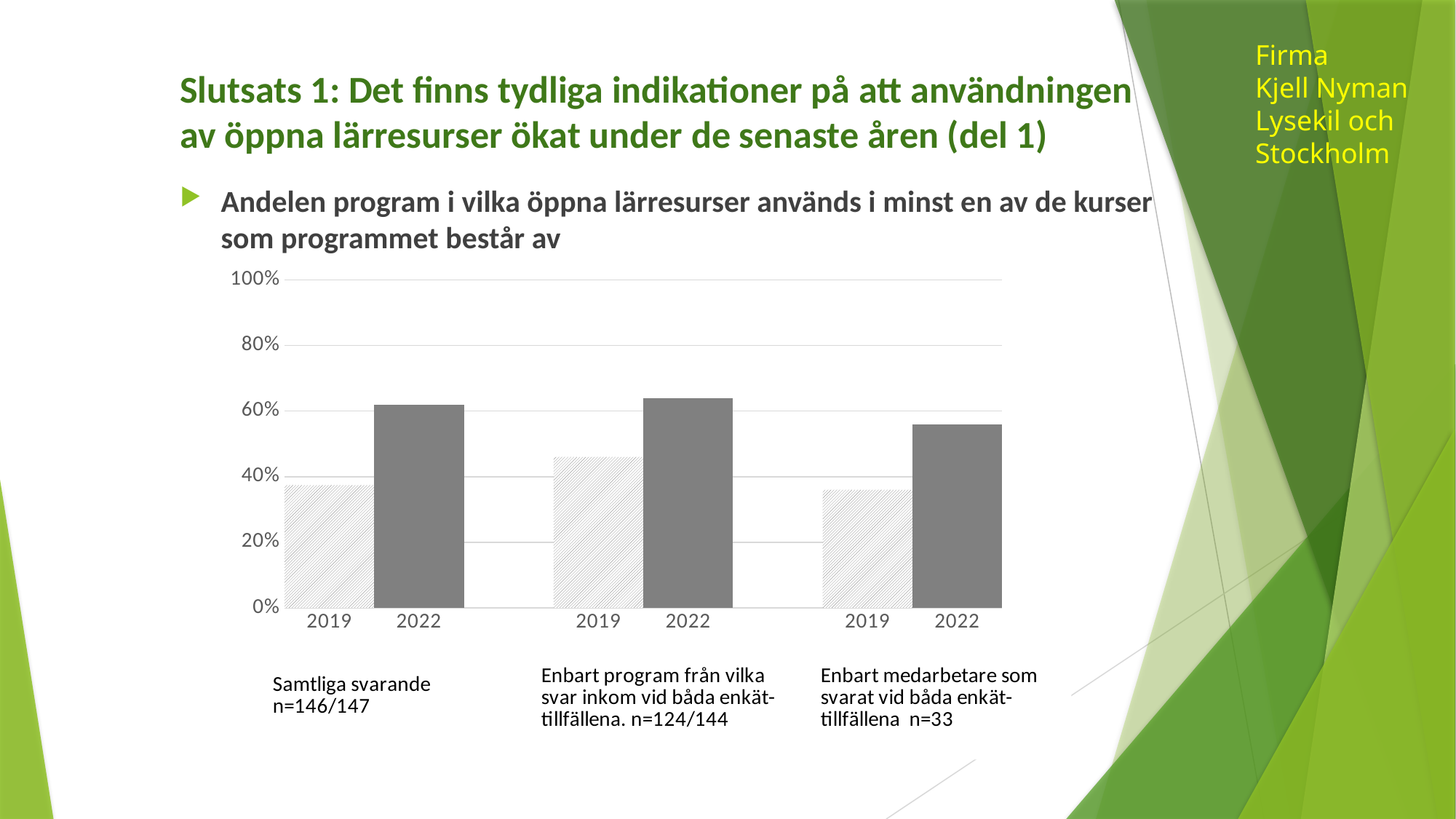
Is the 2022 value for 'Samtliga svarande n=146/147' greater or less than 60%? greater For 'Samtliga svarande n=146/147', which year has the higher value, 2019 or 2022? 2022 How many bars are plotted in the chart? 6 Is the 2022 value for 'Enbart medarbetare som svarat vid båda enkättillfällena n=33' greater or less than 60%? less Within each group, does the value rise or fall from 2019 to 2022? rise How many groups of bars does the chart show? 3 What is the highest value shown on the vertical axis of the chart? 100% Is the 2019 value for 'Enbart medarbetare som svarat vid båda enkättillfällena n=33' greater or less than 40%? less What kind of chart is shown on the slide? bar chart Which 2019 bar is higher: 'Samtliga svarande n=146/147' or 'Enbart program från vilka svar inkom vid båda enkättillfällena. n=124/144'? Enbart program från vilka svar inkom vid båda enkättillfällena. n=124/144